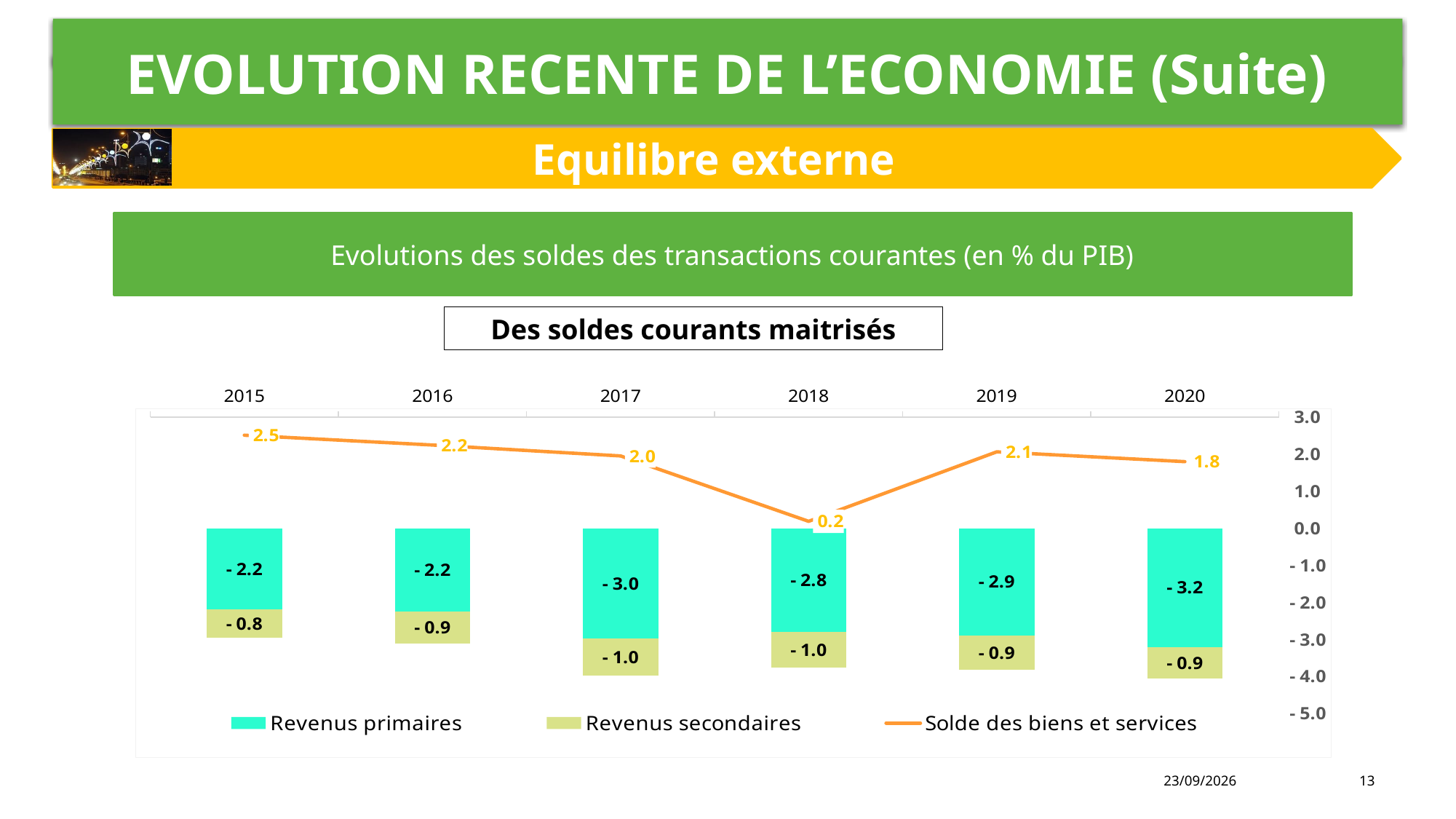
How many years are shown on the x axis? 6 What is the value of Solde des biens et services in 2018? 0.2 By how much did Solde des biens et services fall between 2015 and 2020? 0.7 What is the total of the stacked bar (Revenus primaires plus Revenus secondaires) for 2017? - 4.0 How many series does the legend list? 3 In which year is Solde des biens et services at its lowest? 2018 What is the value of Revenus primaires in 2020? - 3.2 What is the value of Revenus secondaires in 2015? - 0.8 Does Solde des biens et services rise or fall from 2015 to 2018? Fall What kind of chart is this? Combined stacked bar and line chart Which year has the lower Revenus primaires value, 2019 or 2020? 2020 In which year is Solde des biens et services at its highest? 2015